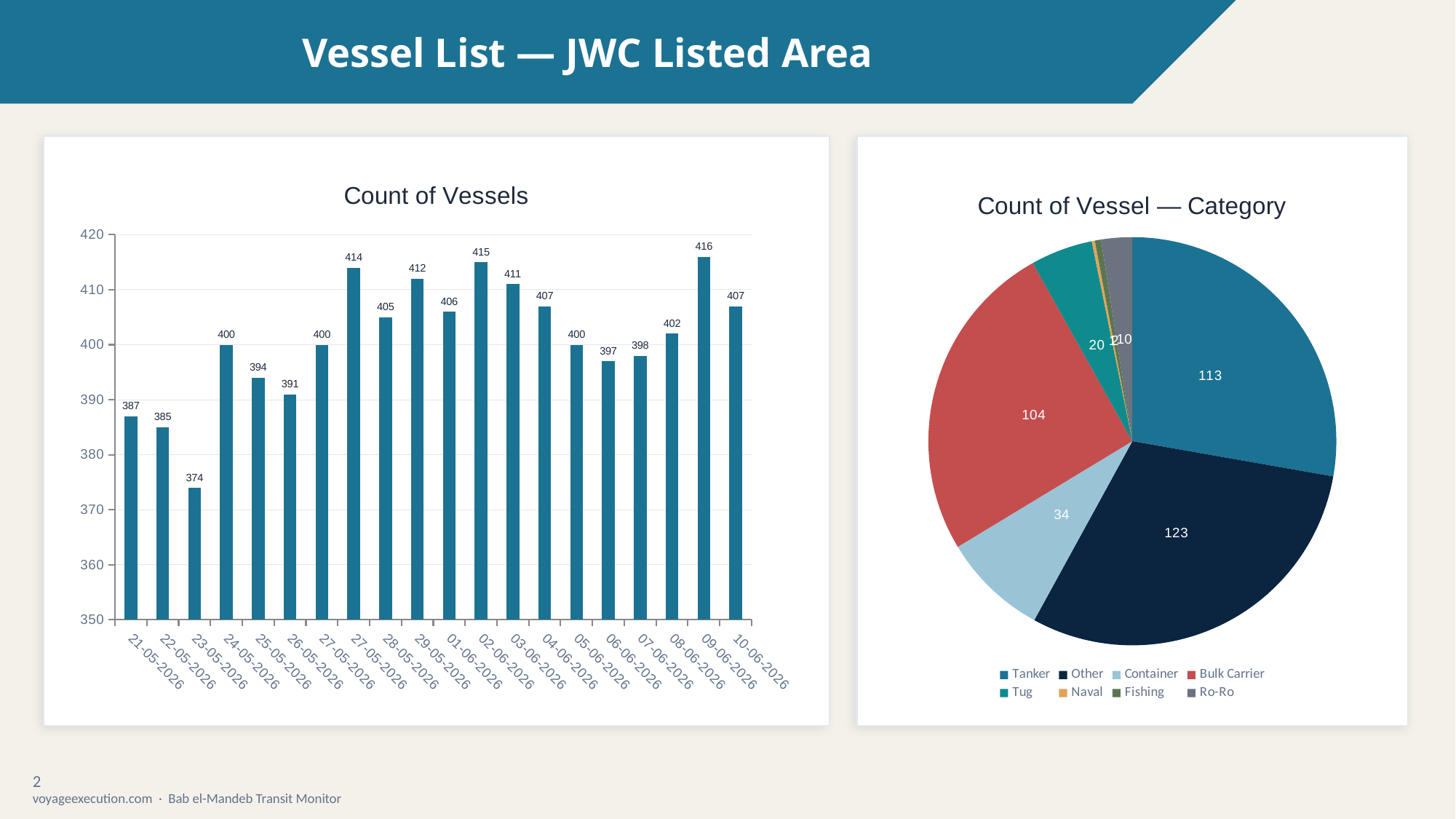
In the "Count of Vessel — Category" pie chart, which category has the largest slice? Other In the "Count of Vessels" chart, which date has the lowest count? 23-05-2026 In the "Count of Vessel — Category" pie chart, what is the difference between the Tanker and Container values? 79 How many categories does the legend of the "Count of Vessel — Category" pie chart list? 8 How many bars are plotted in the "Count of Vessels" chart? 20 What kind of chart is the "Count of Vessels" chart on the left? bar chart In the "Count of Vessel — Category" pie chart, what is the value for Other? 123 In the "Count of Vessels" chart, which is larger, the value for 02-06-2026 or 03-06-2026? 02-06-2026 In the "Count of Vessels" chart, what is the value for 21-05-2026? 387 In the "Count of Vessels" chart, what is the difference between the values for 09-06-2026 and 23-05-2026? 42 In the "Count of Vessels" chart, which date has the highest count? 09-06-2026 In the "Count of Vessels" chart, what is the value for 10-06-2026? 407